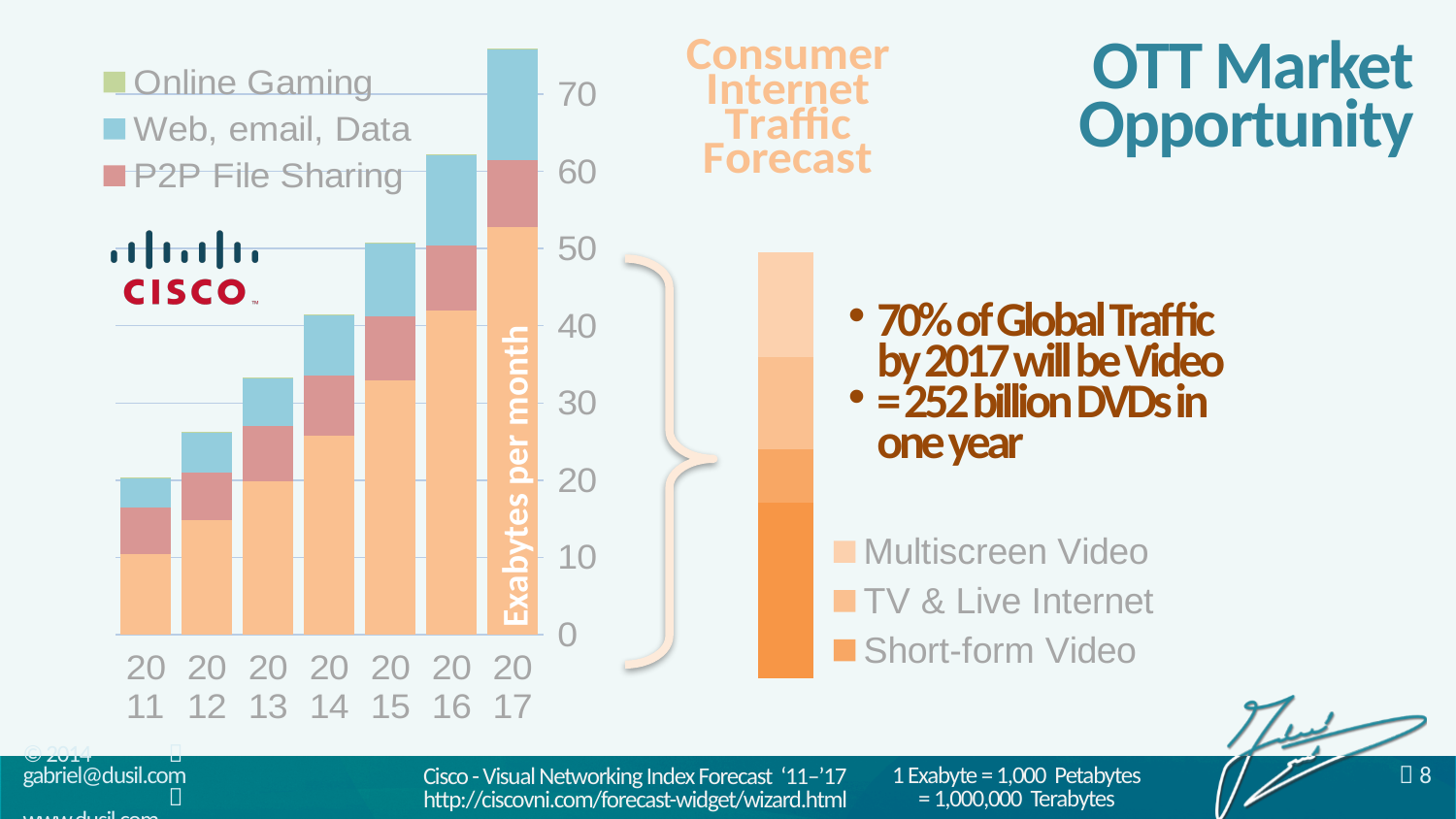
In the Consumer Internet Traffic Forecast chart, which year has the shortest stacked bar? 2011 What kind of chart is the Consumer Internet Traffic Forecast chart? stacked bar chart In the Consumer Internet Traffic Forecast chart, is the total for 2012 greater or less than 30 exabytes per month? less In the Consumer Internet Traffic Forecast chart, which year has the tallest stacked bar? 2017 In the Consumer Internet Traffic Forecast chart, is the total for 2016 greater or less than 60 exabytes per month? greater How many series does the legend of the Consumer Internet Traffic Forecast chart list? 3 In the Consumer Internet Traffic Forecast chart, do the total bar heights rise or fall from 2011 to 2017? rise In the Consumer Internet Traffic Forecast chart, which year has the larger total bar, 2013 or 2016? 2016 How many years are shown on the x axis of the Consumer Internet Traffic Forecast chart? 7 What is the y-axis title of the Consumer Internet Traffic Forecast chart? Exabytes per month In the Consumer Internet Traffic Forecast chart, is the total for 2017 greater or less than 70 exabytes per month? greater How many series does the legend of the single stacked bar on the right of the slide list? 3